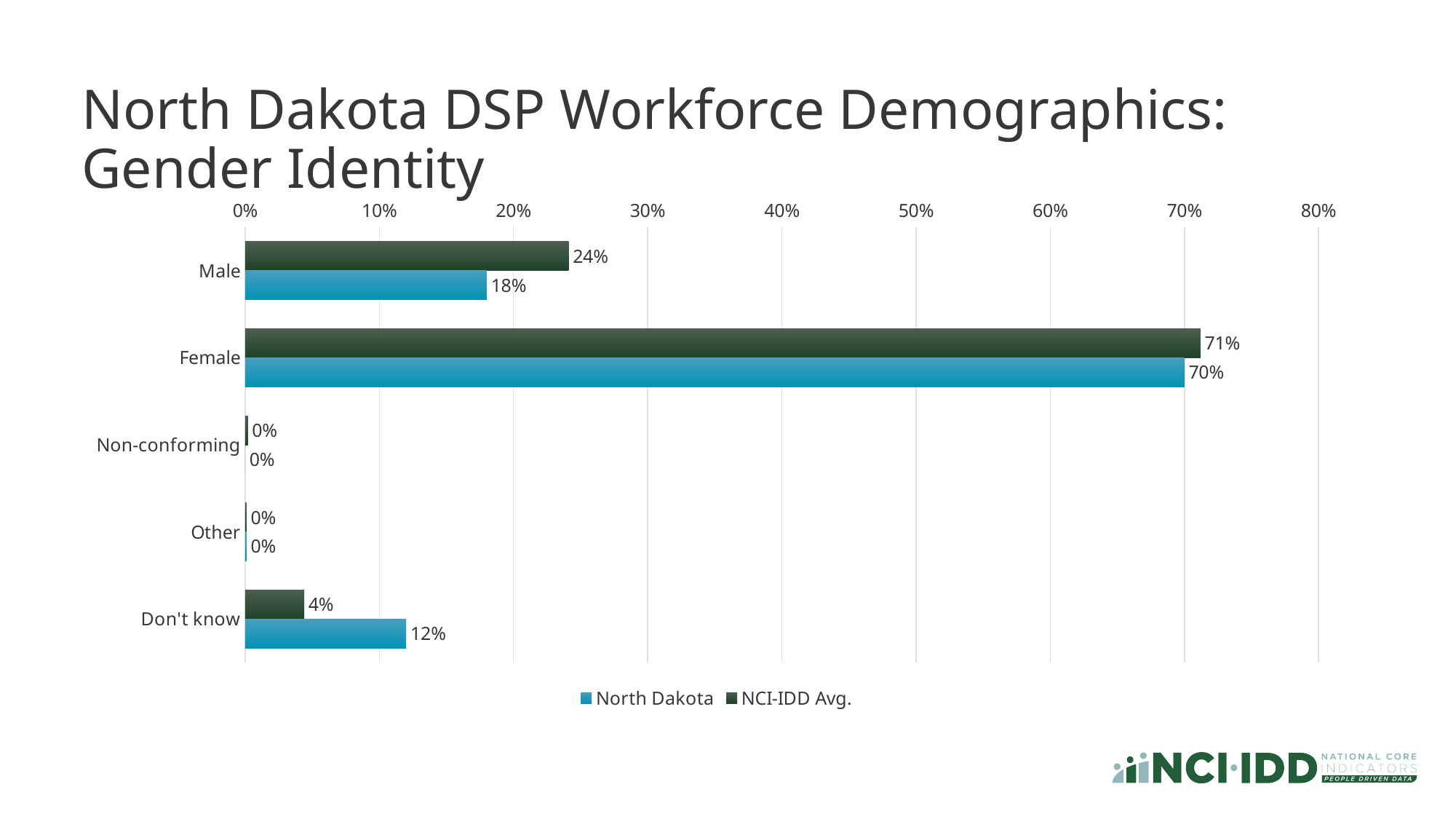
What kind of chart is shown on the slide? Bar chart Which is larger for Female: the North Dakota value or the NCI-IDD Avg. value? NCI-IDD Avg. What is the North Dakota value for Don't know? 12% How many series does the legend list? 2 Which category has the highest North Dakota value? Female What is the North Dakota value for Male? 18% What is the NCI-IDD Avg. value for Don't know? 4% What is the title of the chart? North Dakota DSP Workforce Demographics: Gender Identity What is the difference between the NCI-IDD Avg. and North Dakota values for Male? 6% What is the NCI-IDD Avg. value for Female? 71% What is the difference between the North Dakota and NCI-IDD Avg. values for Don't know? 8% How many categories are shown on the chart? 5